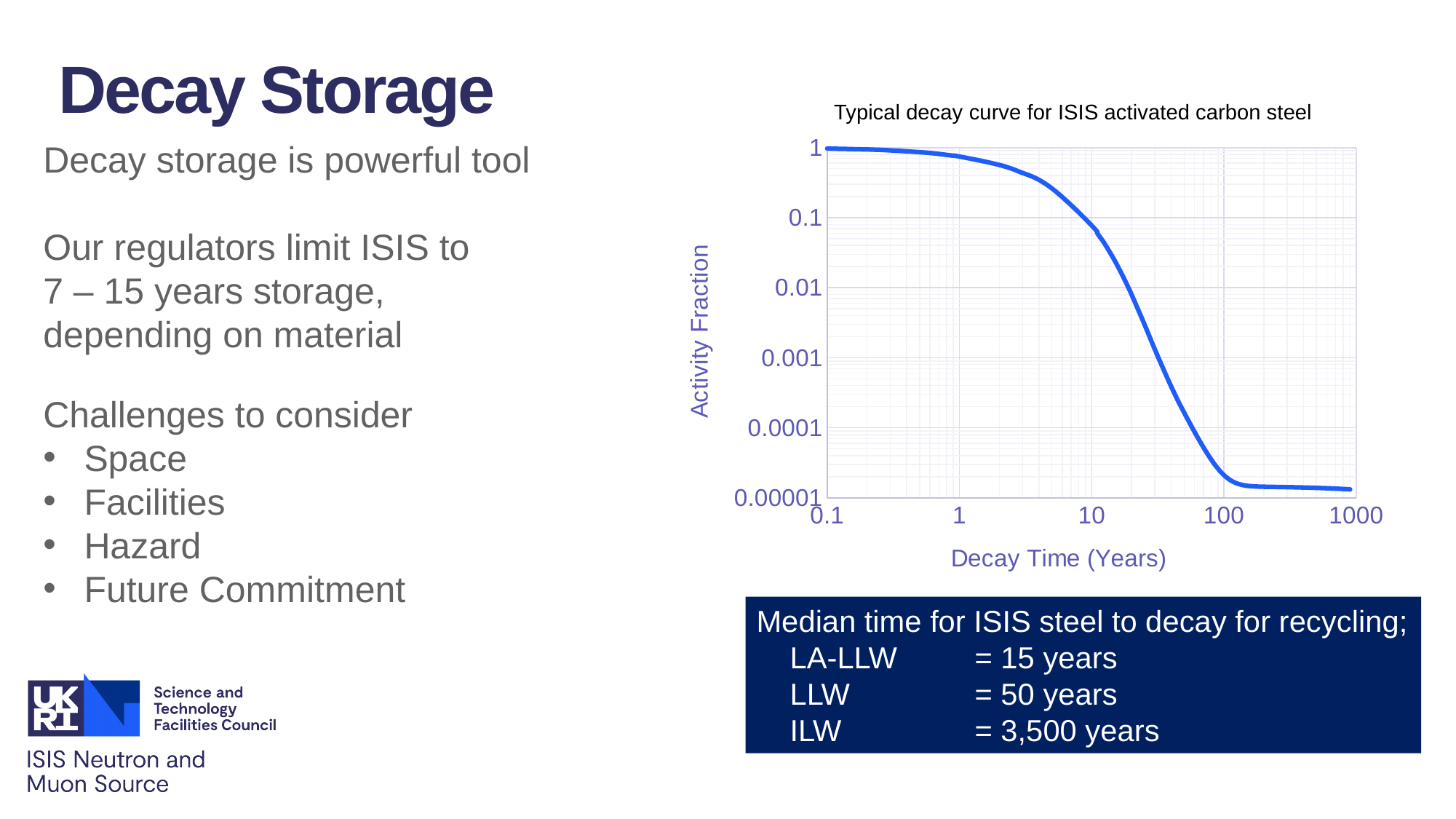
Is the activity fraction at a decay time of 0.1 years greater or less than 0.1? greater Is the activity fraction larger at a decay time of 1 year or at 100 years? 1 year What is the label of the x axis of the chart? Decay Time (Years) How many lines are plotted on the chart? 1 What is the title of the chart? Typical decay curve for ISIS activated carbon steel What kind of chart is shown on the slide? line chart Is the activity fraction at a decay time of 100 years greater or less than 0.0001? less Does the activity fraction rise or fall as decay time increases along the x axis? fall Is the activity fraction at a decay time of 1000 years greater or less than 0.001? less